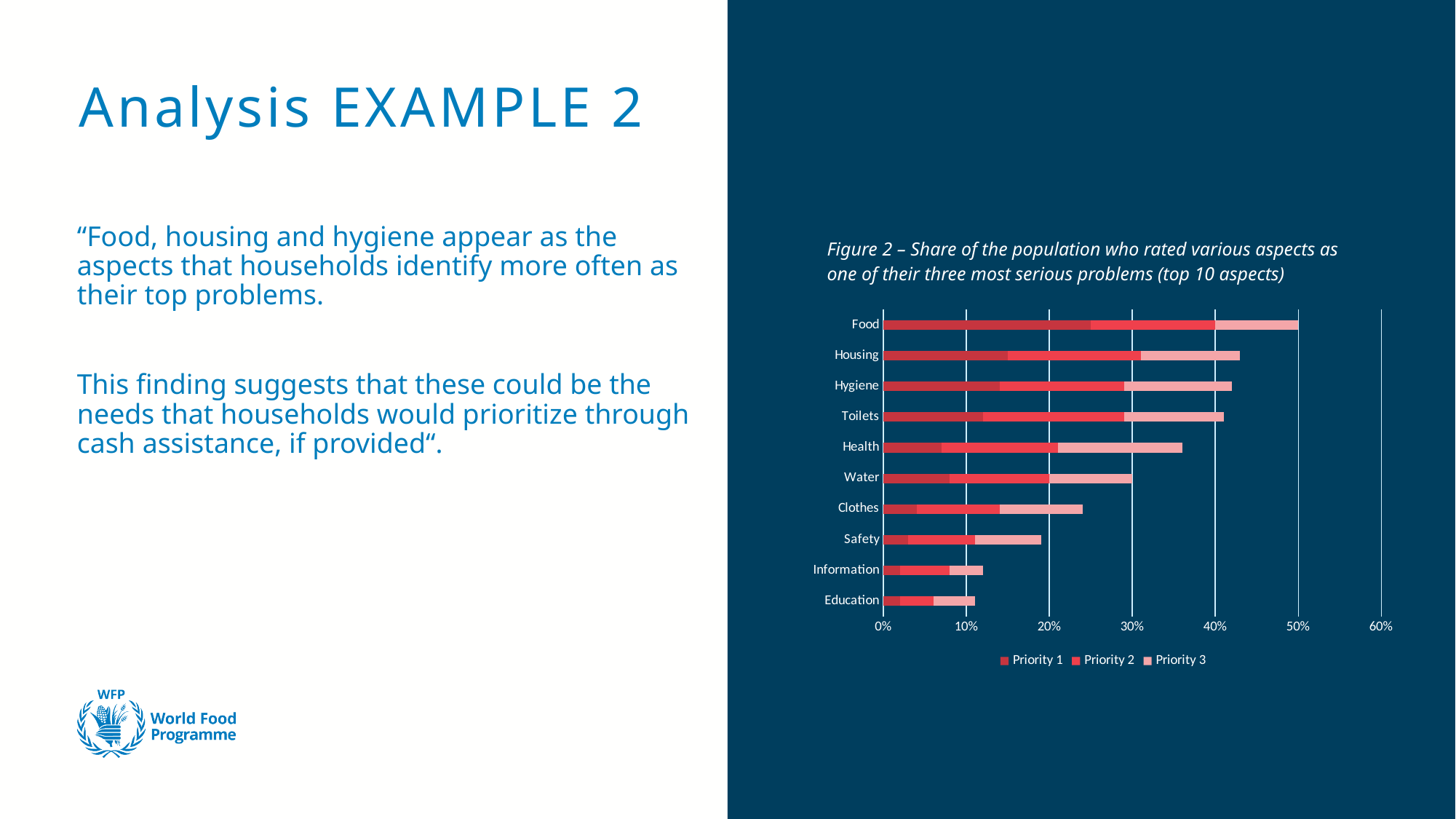
Is the total value for Housing greater or less than 40%? greater Which aspect has the longest total bar? Food How many series does the legend list? 3 Is the total value for Clothes greater or less than 20%? greater What are the three series named in the legend? Priority 1, Priority 2, Priority 3 Is the total value for Information greater or less than 20%? less Which has a longer total bar, Health or Clothes? Health How many aspects (categories) are listed on the chart? 10 Which has a longer total bar, Food or Water? Food Which aspect is listed at the top of the chart? Food What kind of chart is shown in Figure 2? Stacked bar chart